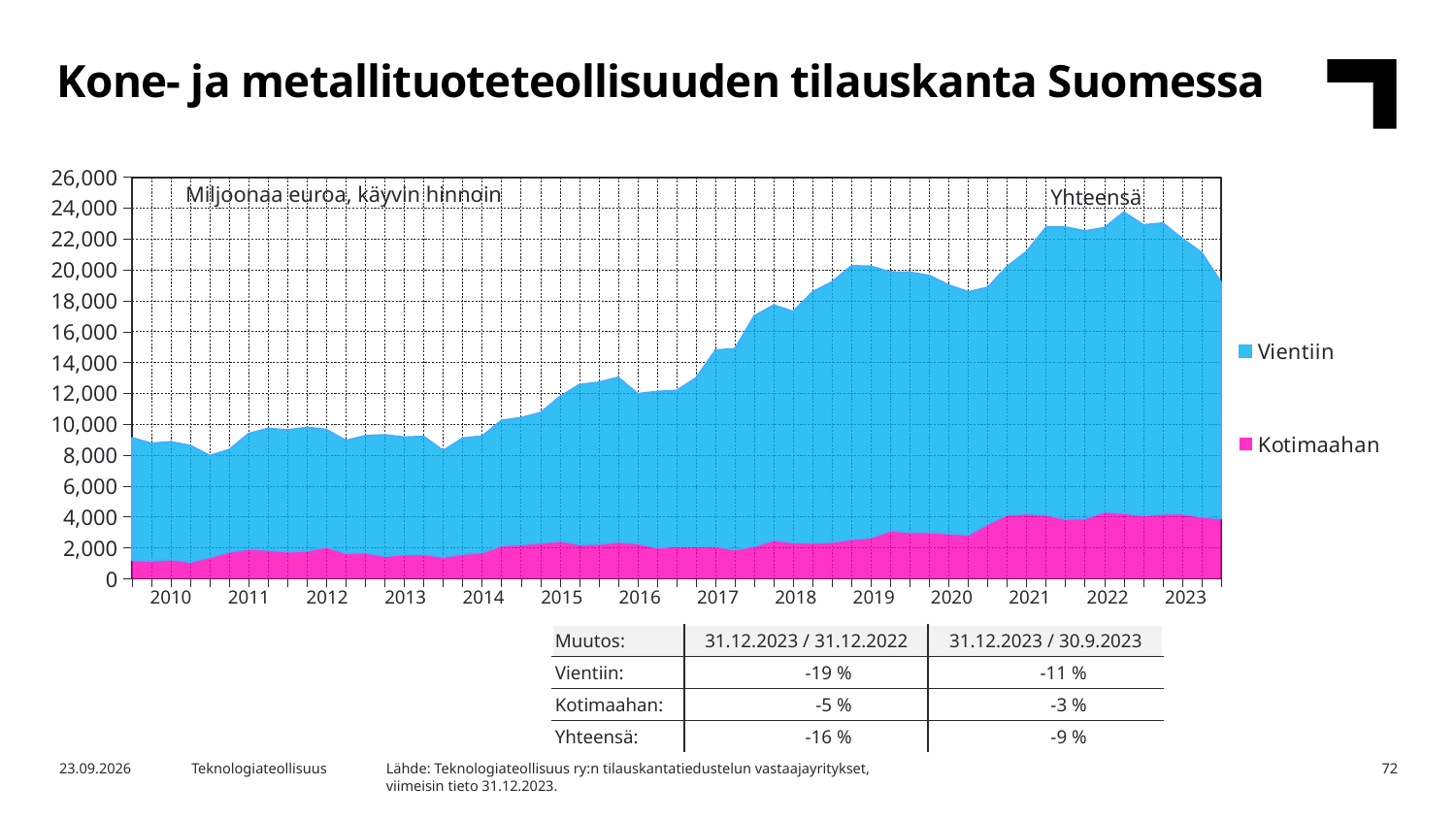
How many years are labelled on the x axis of the chart? 14 Is the total (Yhteensä) value at the end of 2023 greater or less than 20,000? less Which series is larger throughout the chart, Vientiin or Kotimaahan? Vientiin Is the Kotimaahan value at the start of 2010 greater or less than 2,000? less What type of chart is shown on the slide? Stacked area chart What unit is stated in the label at the top left of the chart area? Miljoonaa euroa, käyvin hinnoin Is the total (Yhteensä) value at the start of 2010 greater or less than 8,000? greater Does the total order backlog (Yhteensä) generally rise or fall from 2010 to 2022? rise What are the two series named in the chart legend? Vientiin and Kotimaahan How many series does the chart legend list? 2